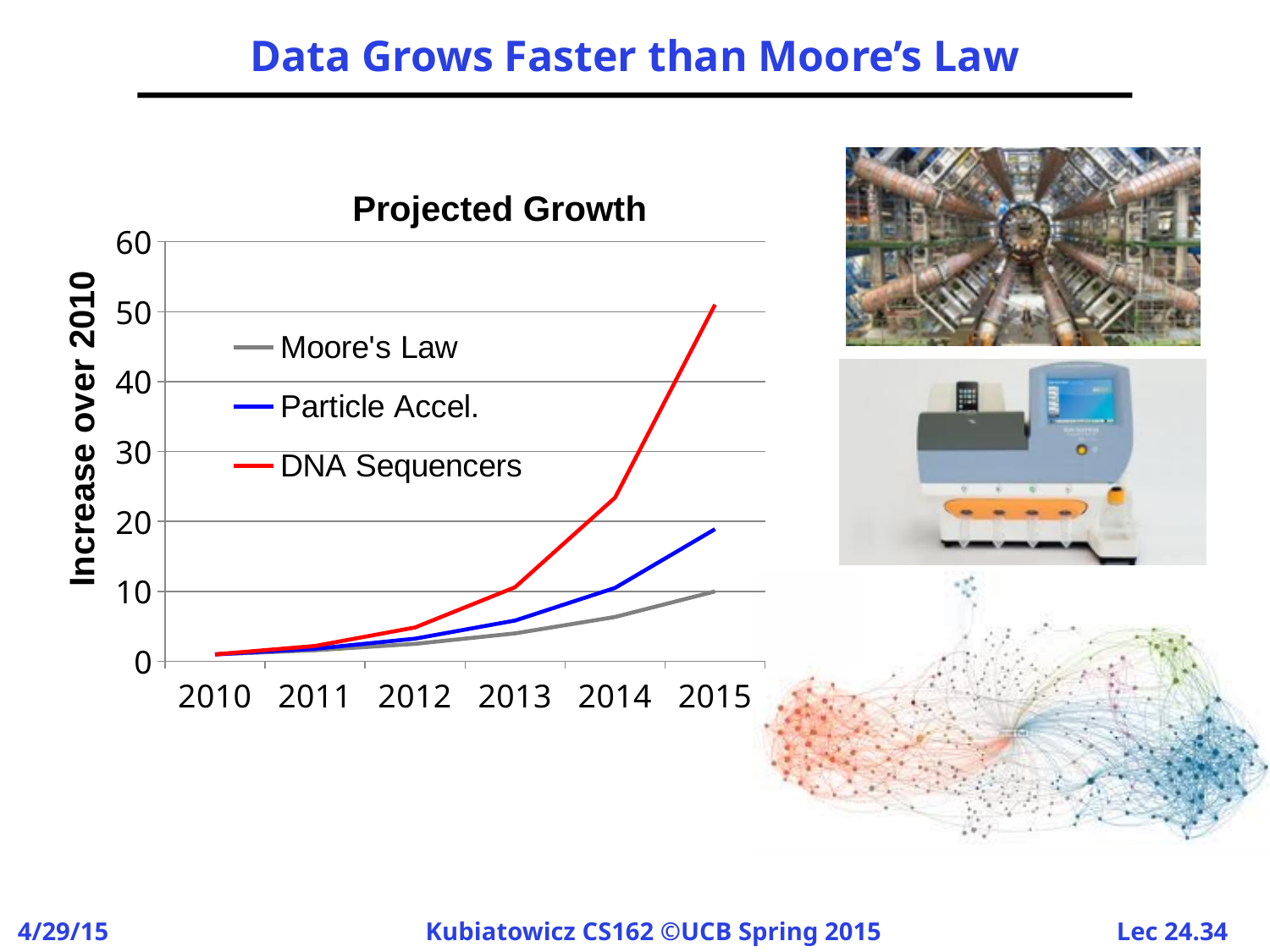
Is the value for DNA Sequencers in 2015 greater or less than 40? greater Is the value for Moore's Law in 2015 greater or less than 20? less What colour is the DNA Sequencers line? red Is the value for Particle Accel. in 2015 greater or less than 30? less What kind of chart is shown on the slide? line chart What is the title of the chart? Projected Growth Which series has the lowest value in 2015? Moore's Law In 2015, which is larger: Particle Accel. or Moore's Law? Particle Accel. Do the values for DNA Sequencers rise or fall from 2010 to 2015? rise Which series has the highest value in 2015? DNA Sequencers How many series does the legend of the Projected Growth chart list? 3 How many years are shown along the x axis of the Projected Growth chart? 6